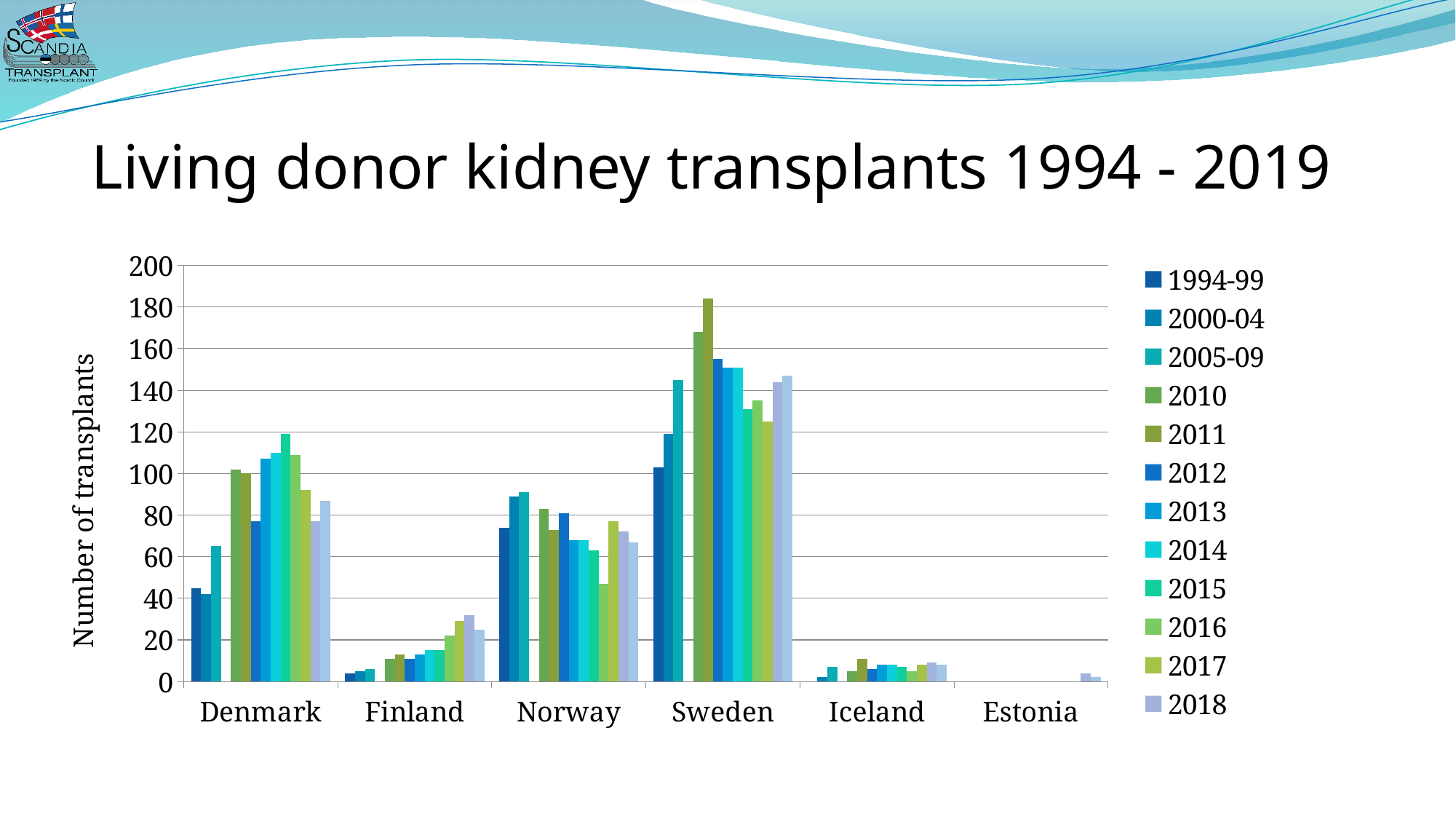
Which is larger for Norway: the value for 2016 or the value for 2017? 2017 Is the value for Finland in 2018 greater or less than 40? less How many series does the chart's legend list? 12 What is the label on the vertical axis of the chart? Number of transplants Is the value for Denmark in 2015 greater or less than 100? greater Which country has the larger value for 2010: Denmark or Sweden? Sweden Is the value for Sweden in 2011 greater or less than 160? greater Do Finland's values generally rise or fall from 1994-99 through 2018? rise What kind of chart is shown on the slide? bar chart Which country has the highest number of living donor kidney transplants in the chart? Sweden How many countries are shown on the x axis of the chart? 6 Which country has the lowest number of living donor kidney transplants in the chart? Estonia